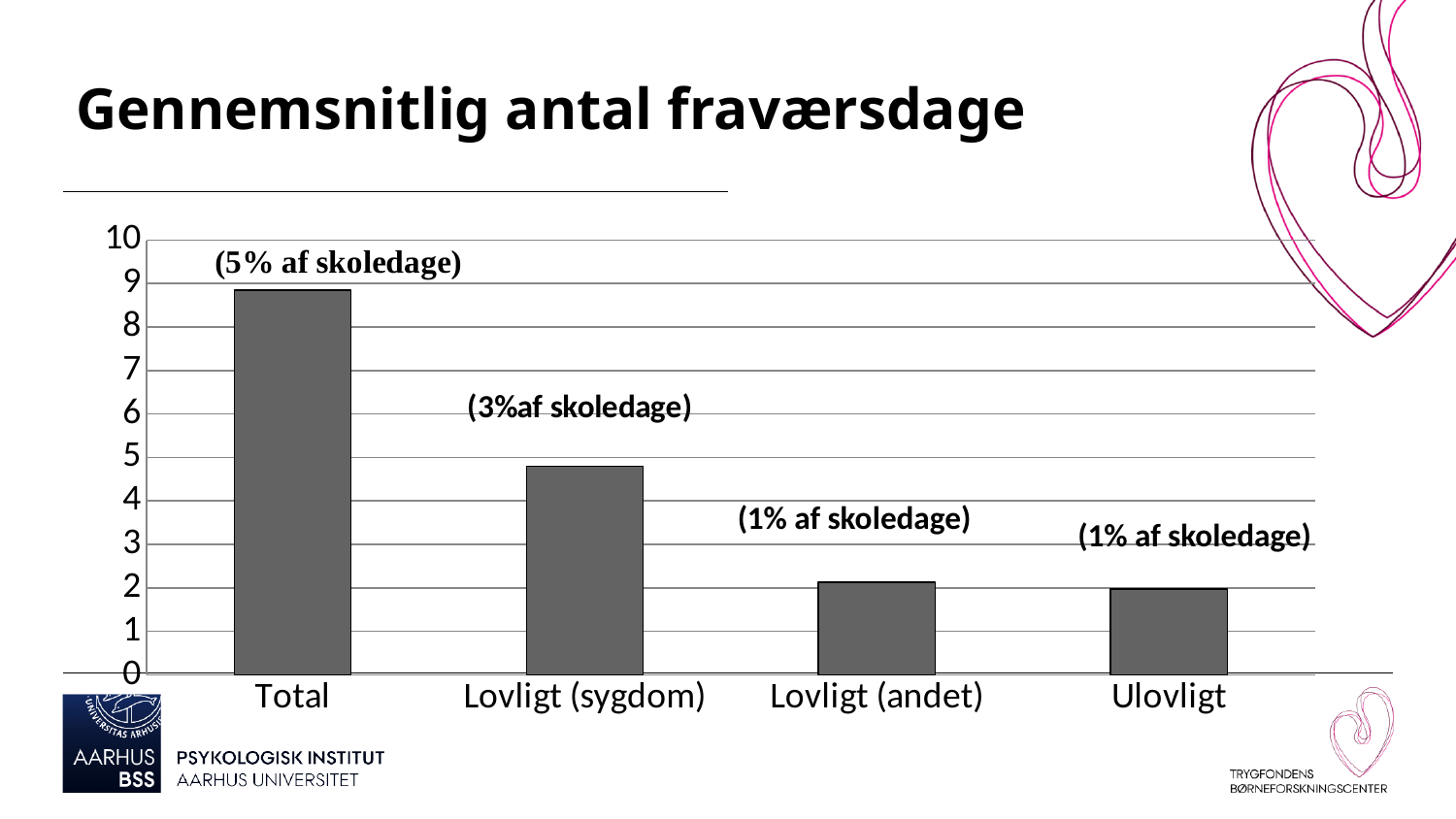
What is the title of the chart? Gennemsnitlig antal fraværsdage Is the value for Lovligt (sygdom) greater or less than 4? greater What kind of chart is shown on the slide? bar chart How many categories are shown on the x axis of the chart? 4 What percentage of school days does the label above the Total bar state? 5% Which is larger, the value for Lovligt (sygdom) or the value for Ulovligt? Lovligt (sygdom) Which category has the highest average number of absence days? Total Is the value for Ulovligt greater or less than 3? less Is the value for Lovligt (sygdom) greater or less than 5? less Which is larger, the value for Total or the value for Lovligt (sygdom)? Total